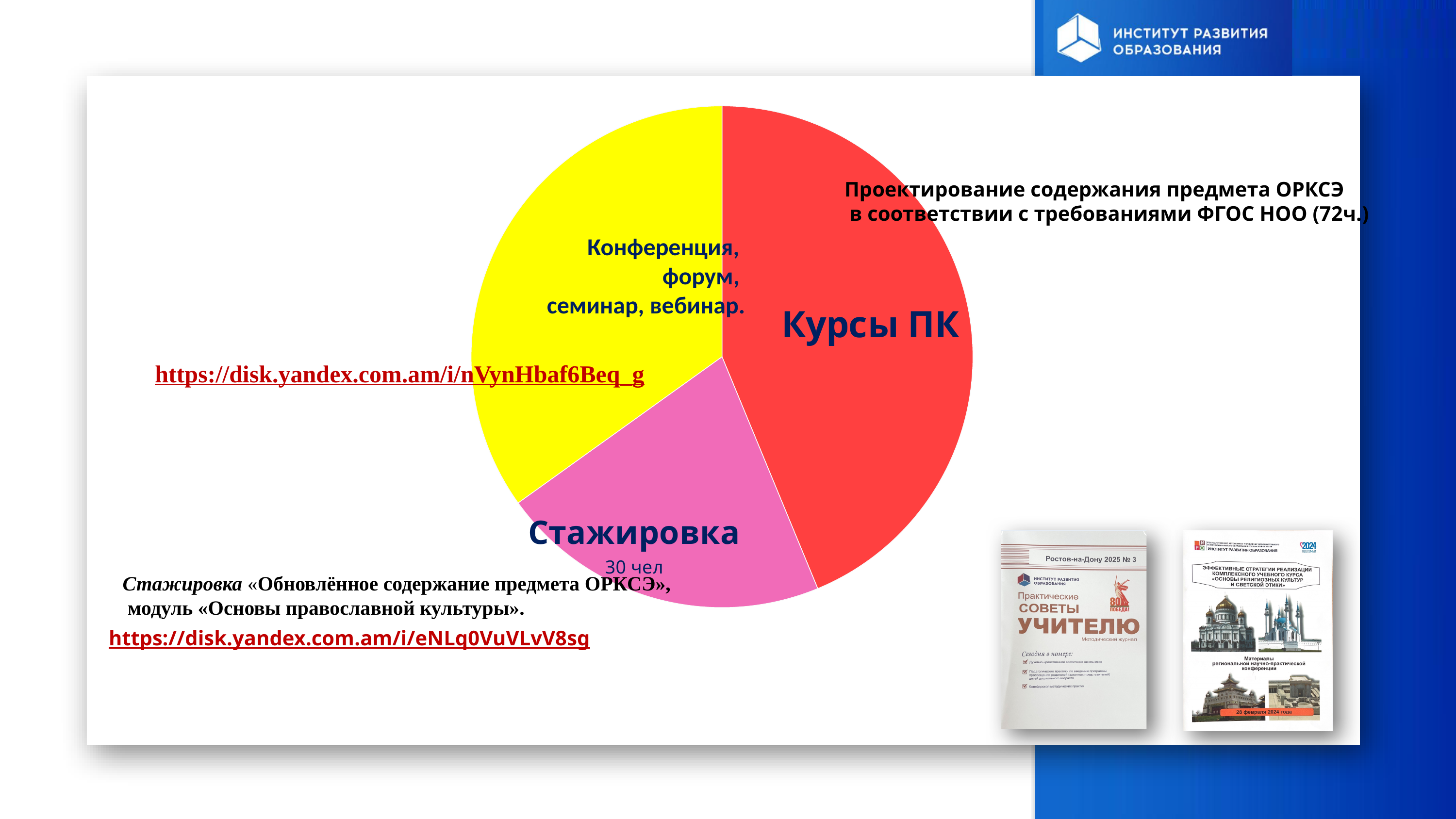
What value is printed for the Стажировка slice? 30 чел What colour is the Курсы ПК slice? red What kind of chart is shown on the slide? pie chart Which slice is larger: Курсы ПК or Стажировка? Курсы ПК What colour is the Стажировка slice? pink Which slice is larger: Конференция, форум, семинар, вебинар or Стажировка? Конференция, форум, семинар, вебинар Which slice of the pie chart is the smallest? Стажировка Which slice of the pie chart is the largest? Курсы ПК How many slices does the pie chart have? 3 Which slice is larger: Курсы ПК or Конференция, форум, семинар, вебинар? Курсы ПК